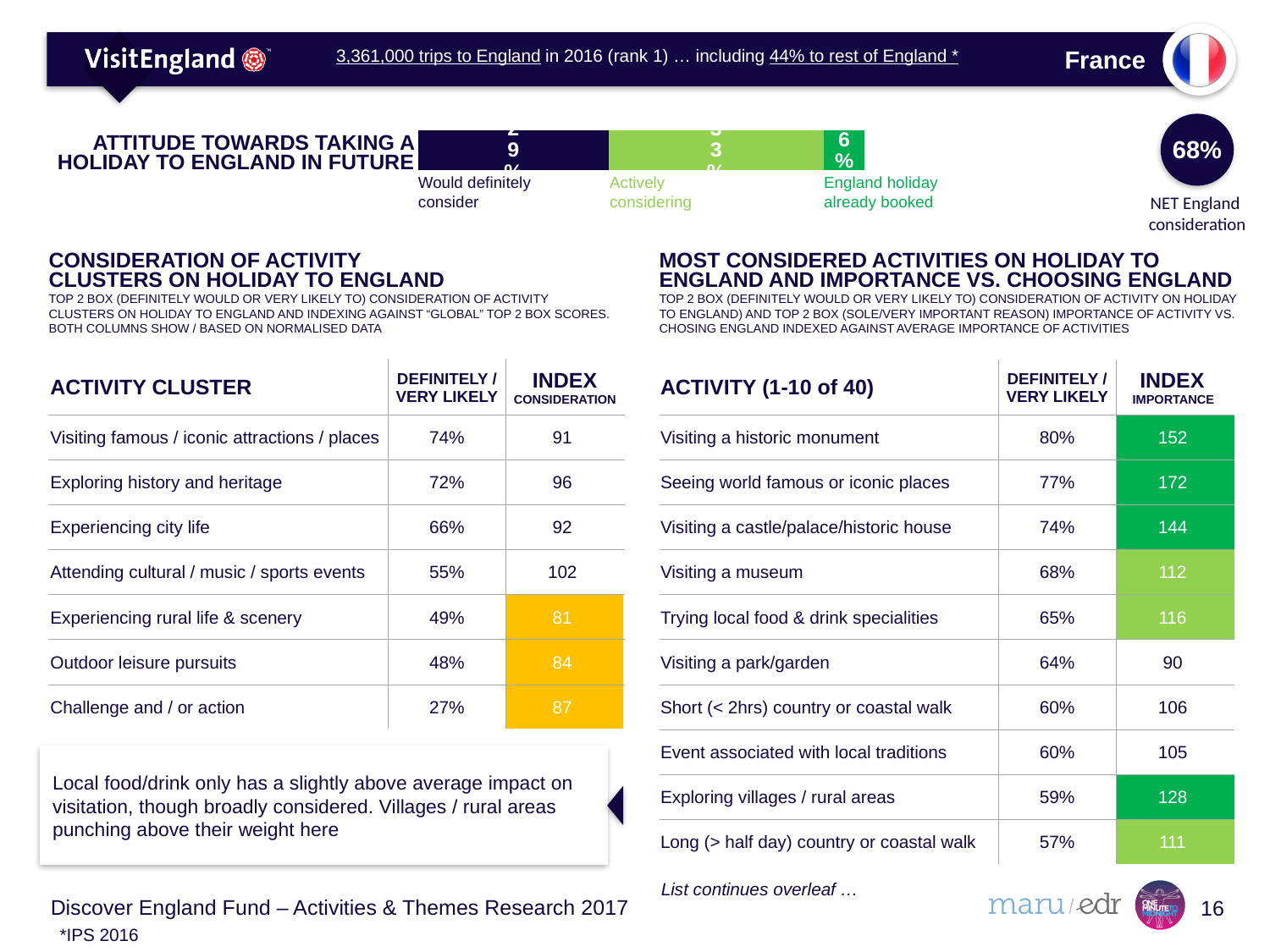
In the 'Attitude towards taking a holiday to England in future' chart, what is the value for 'Actively considering'? 33% How many segments (series) does the 'Attitude towards taking a holiday to England in future' bar chart show? 3 In the 'Attitude towards taking a holiday to England in future' chart, what is the value for 'England holiday already booked'? 6% In the 'Attitude towards taking a holiday to England in future' chart, what is the difference between 'Actively considering' and 'England holiday already booked'? 27 percentage points In the 'Attitude towards taking a holiday to England in future' chart, what is the value for 'Would definitely consider'? 29% In the 'Attitude towards taking a holiday to England in future' chart, which segment has the highest value? Actively considering What kind of chart is used for 'Attitude towards taking a holiday to England in future'? Stacked horizontal bar chart In the 'Attitude towards taking a holiday to England in future' chart, which segment has the lowest value? England holiday already booked What is the total of the three segments in the 'Attitude towards taking a holiday to England in future' stacked bar (the NET England consideration)? 68% In the 'Attitude towards taking a holiday to England in future' chart, what colour is the 'Would definitely consider' segment? Dark navy blue In the 'Attitude towards taking a holiday to England in future' chart, which is larger: 'Would definitely consider' or 'Actively considering'? Actively considering In the 'Attitude towards taking a holiday to England in future' chart, what colour is the 'Actively considering' segment? Green